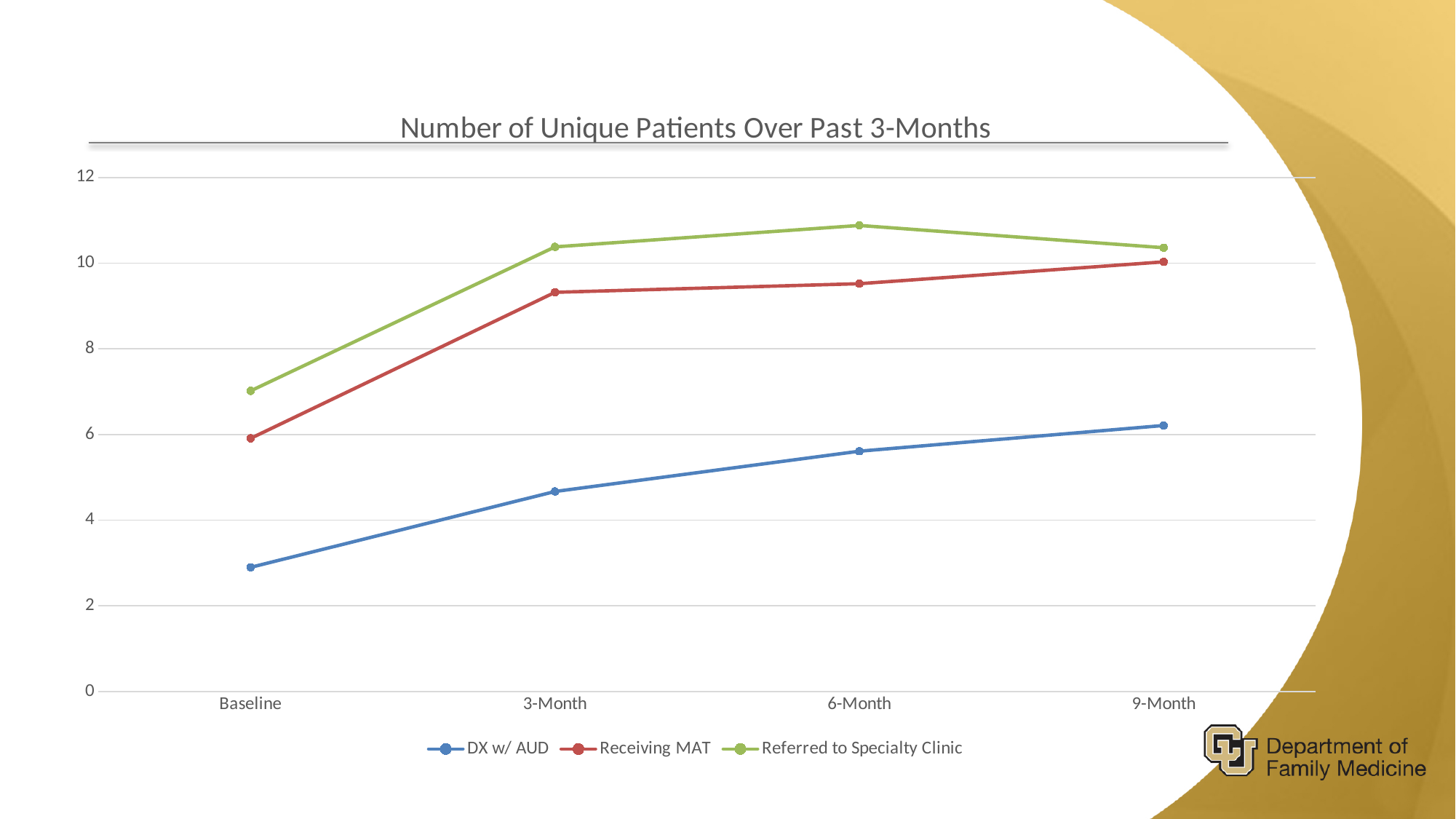
Is the value for Referred to Specialty Clinic at 6-Month greater or less than 10? greater What kind of chart is shown on the slide? line chart How many series does the legend list? 3 At which time point is the DX w/ AUD series lowest? Baseline What is the title of the chart? Number of Unique Patients Over Past 3-Months Is the value for Receiving MAT at 3-Month greater or less than 8? greater Is the value for DX w/ AUD at Baseline greater or less than 4? less At which time point does the Referred to Specialty Clinic series reach its highest value? 6-Month At 3-Month, which is larger: Receiving MAT or DX w/ AUD? Receiving MAT Does the DX w/ AUD series rise or fall from Baseline to 9-Month? rise How many time points are plotted along the x axis? 4